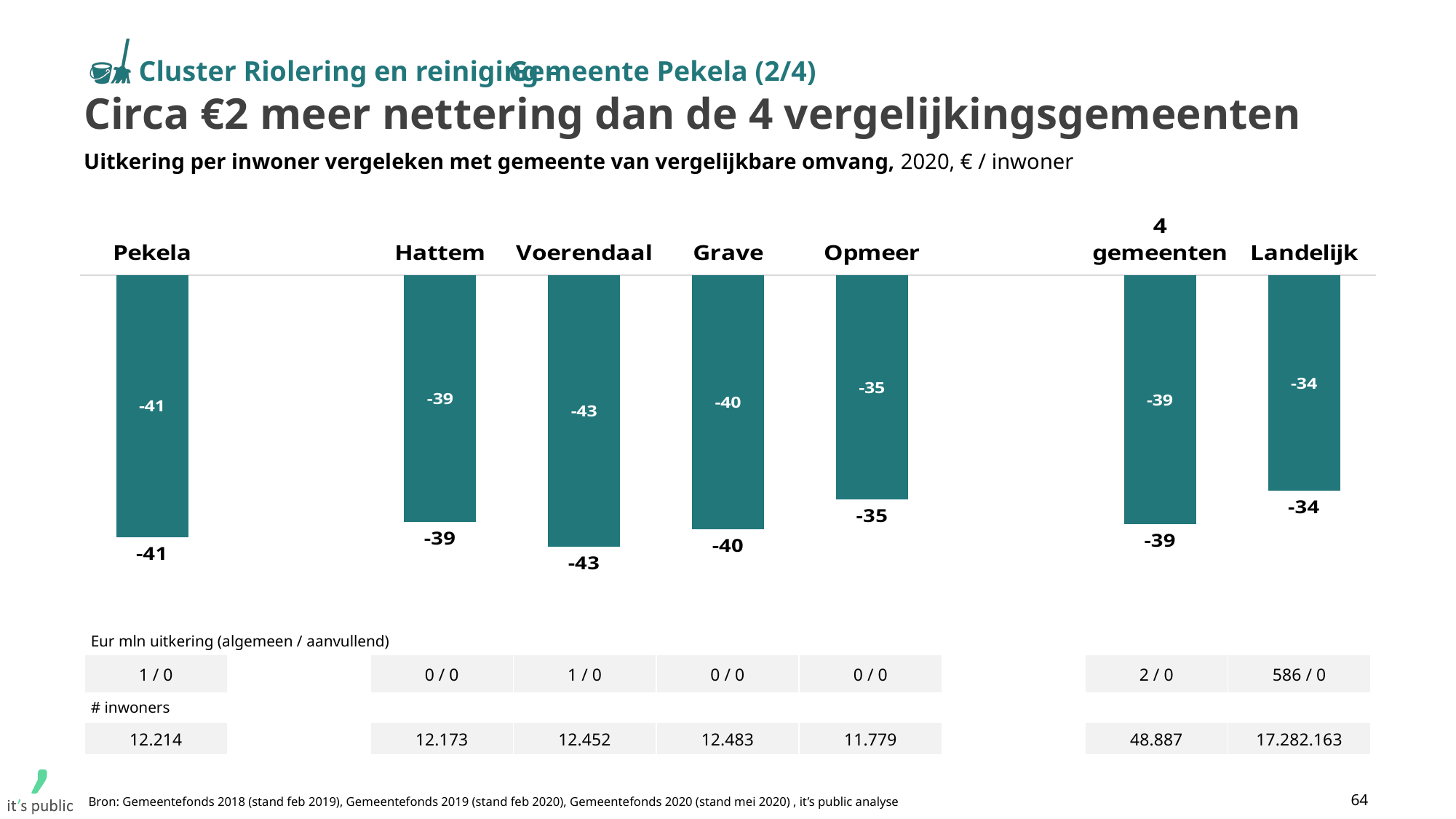
What is the value for Pekela? -41 What is the value for Voerendaal? -43 Which category has the highest (least negative) value? Landelijk What is the value for Landelijk? -34 Which category has the lowest (most negative) value? Voerendaal How many categories are shown in the chart? 7 What kind of chart is shown on the slide? Bar chart What is the difference between the values for Voerendaal and Opmeer? 8 Which has the more negative value, Hattem or Grave? Grave What is the difference between the values for Pekela and 4 gemeenten? 2 What is the value for 4 gemeenten? -39 What is the value for Opmeer? -35